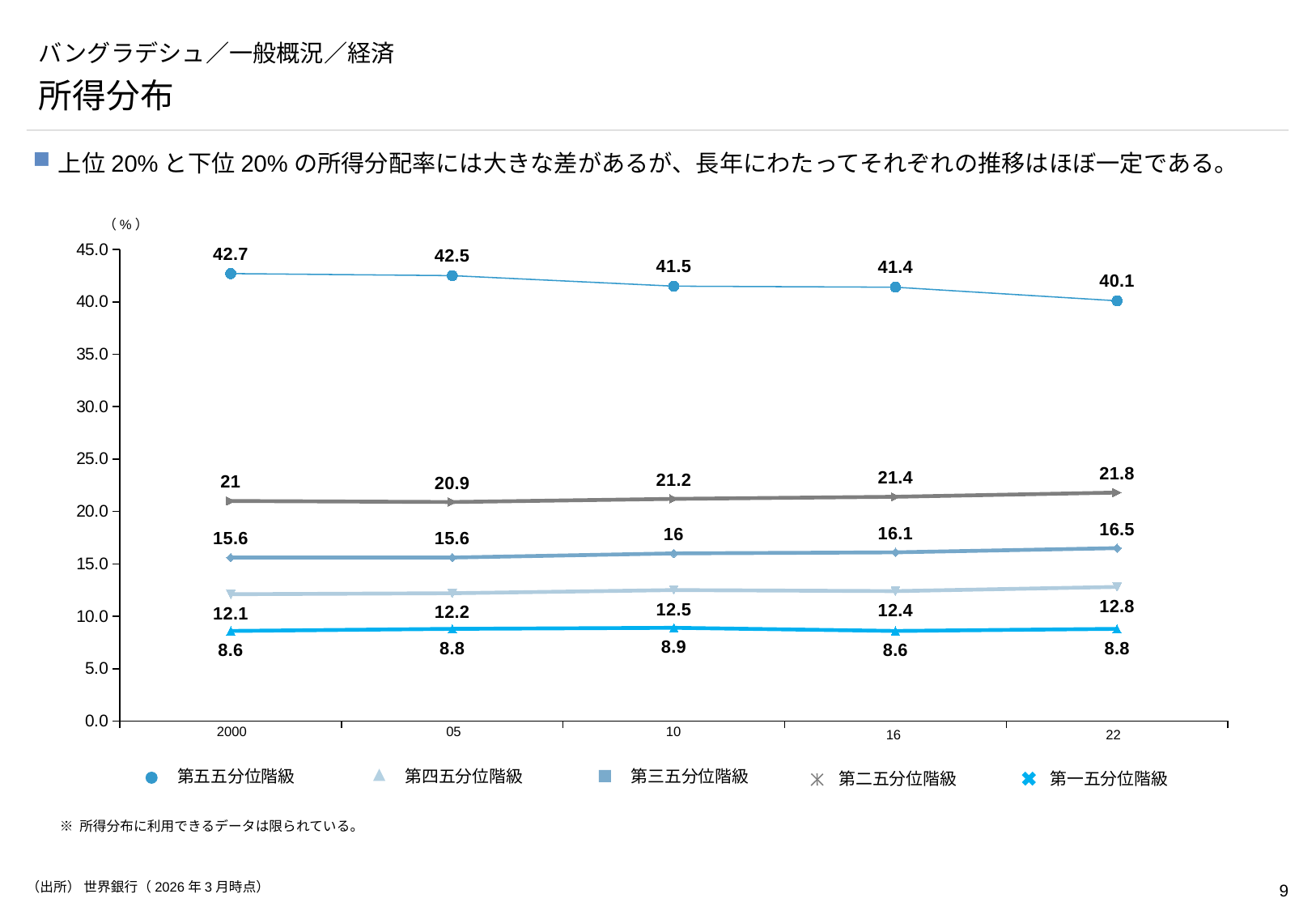
What is the difference between 第五五分位階級 and 第一五分位階級 in 22? 31.3 Does the value for 第五五分位階級 rise or fall from 2000 to 22? fall Which is larger for 第五五分位階級: the value in 2000 or in 05? 2000 How many years are shown on the x axis? 5 What is the value for 第五五分位階級 in 22? 40.1 What is the value for 第一五分位階級 in 10? 8.9 What is the value for 第五五分位階級 in 2000? 42.7 By how much did the value for 第五五分位階級 change between 2000 and 22? 2.6 In which year is the value for 第一五分位階級 highest? 10 How many series does the legend list? 5 In which year is the value for 第五五分位階級 highest? 2000 What is the value for 第一五分位階級 in 2000? 8.6